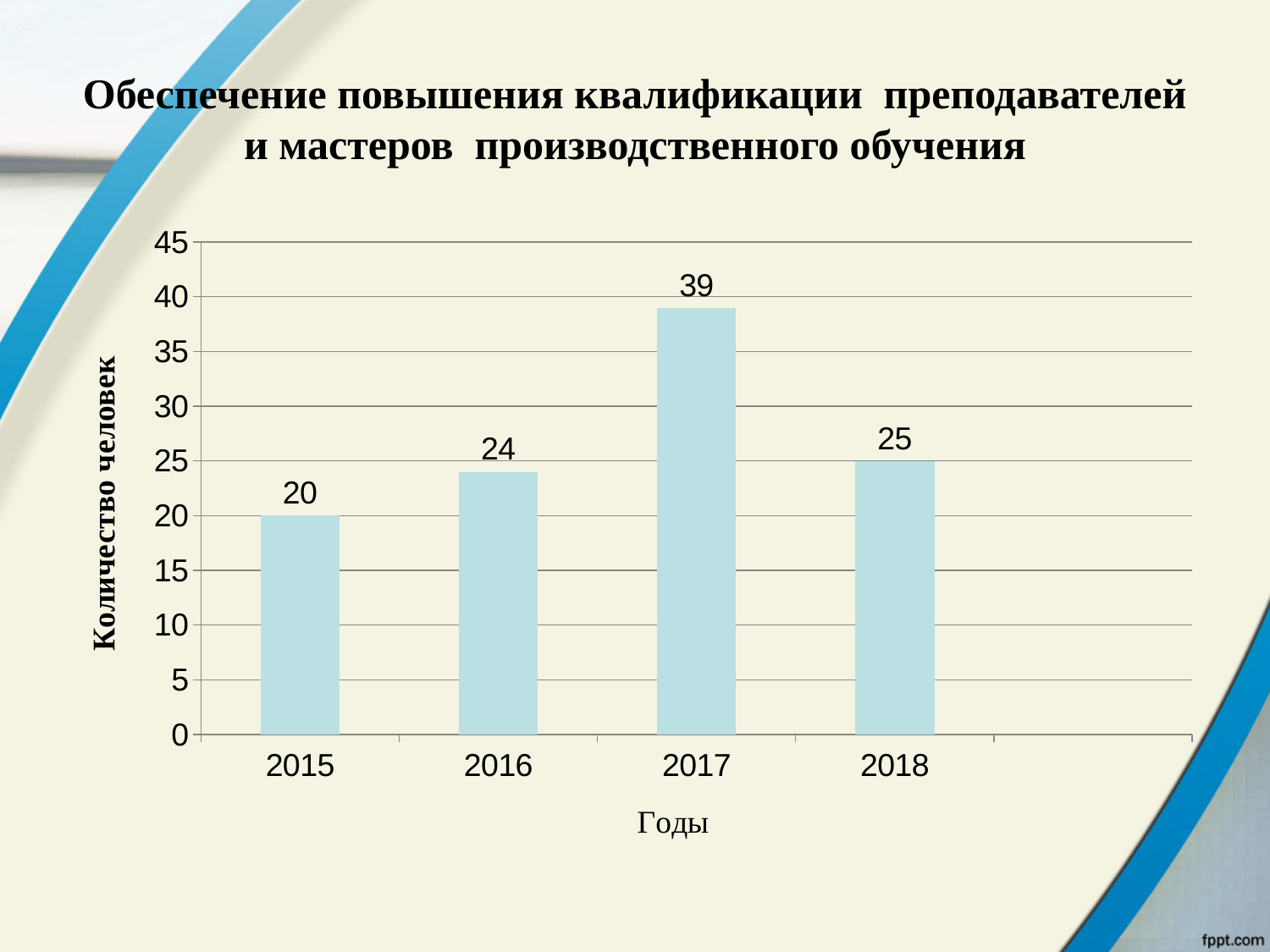
How many years are shown on the x axis? 4 What is the difference between the values for 2017 and 2016? 15 What is the value for 2018? 25 Is the value for 2017 greater or less than 35? greater What is the value for 2017? 39 What is the value for 2015? 20 Which year has the highest value? 2017 What kind of chart is shown on the slide? bar chart What is the difference between the values for 2018 and 2015? 5 Which is larger, the value for 2016 or the value for 2018? 2018 What is the label of the y axis? Количество человек Which year has the lowest value? 2015